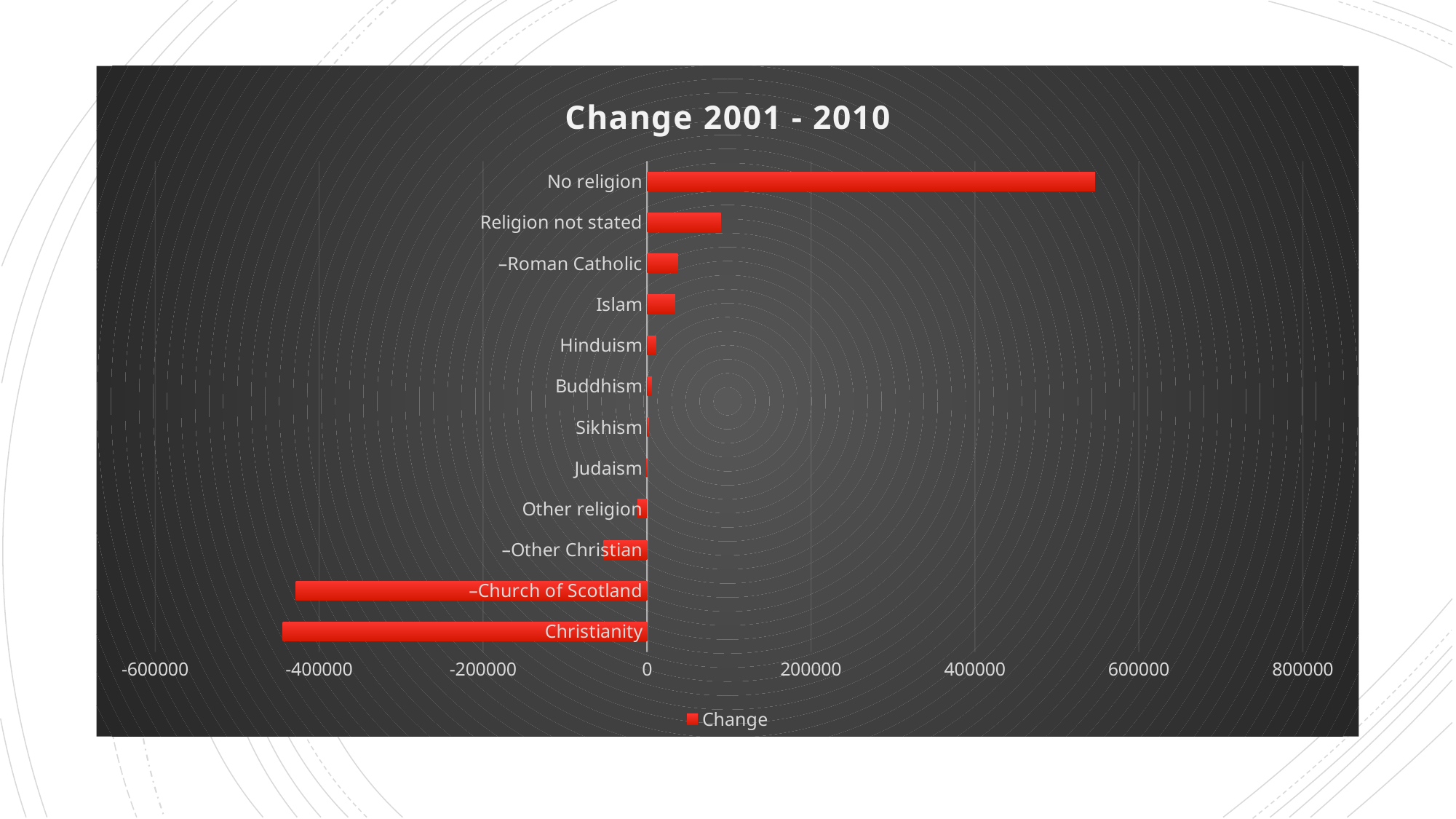
Is the value for No religion greater or less than 400000? greater Which category has the highest value in the chart? No religion What is the name of the series shown in the legend? Change Is the value for Christianity greater or less than -600000? greater Which has the larger value, No religion or Religion not stated? No religion How many series does the legend list? 1 Is the value for Church of Scotland greater or less than -200000? less What is the title of the chart? Change 2001 - 2010 What type of chart is shown on the slide? Bar chart How many categories are plotted in the chart? 12 Which has the larger value, Islam or Other Christian? Islam